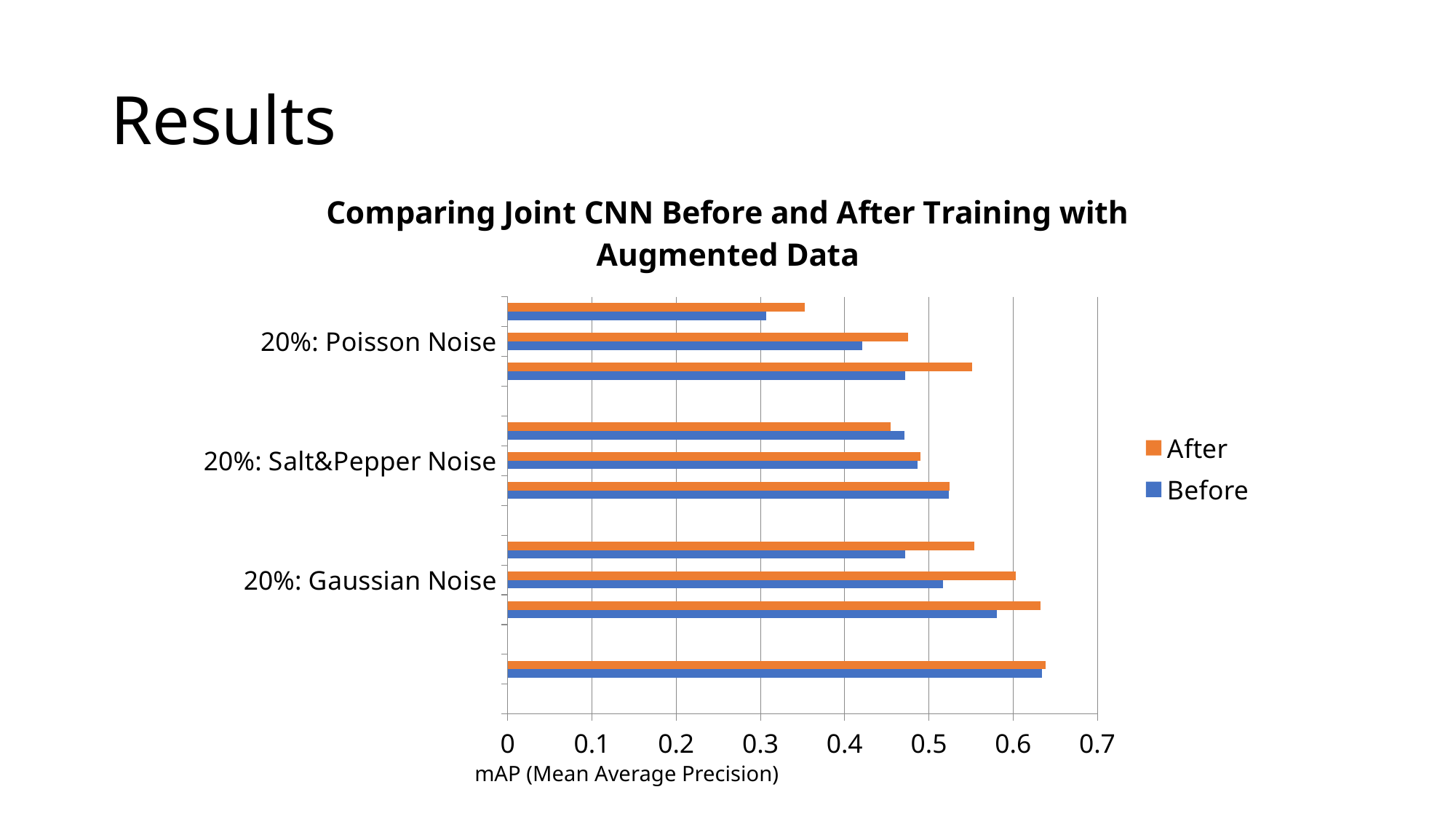
Is the Before value for 20%: Poisson Noise greater or less than 0.5? less For 20%: Poisson Noise, which is larger, the After value or the Before value? After Is the After value for 20%: Gaussian Noise greater or less than 0.5? greater What kind of chart is shown on the slide? bar chart Is the After value for 20%: Poisson Noise greater or less than 0.6? less What is the label on the horizontal axis of the chart? mAP (Mean Average Precision) What is the title of the chart? Comparing Joint CNN Before and After Training with Augmented Data For 20%: Gaussian Noise, which is larger, the After value or the Before value? After How many series does the legend list? 2